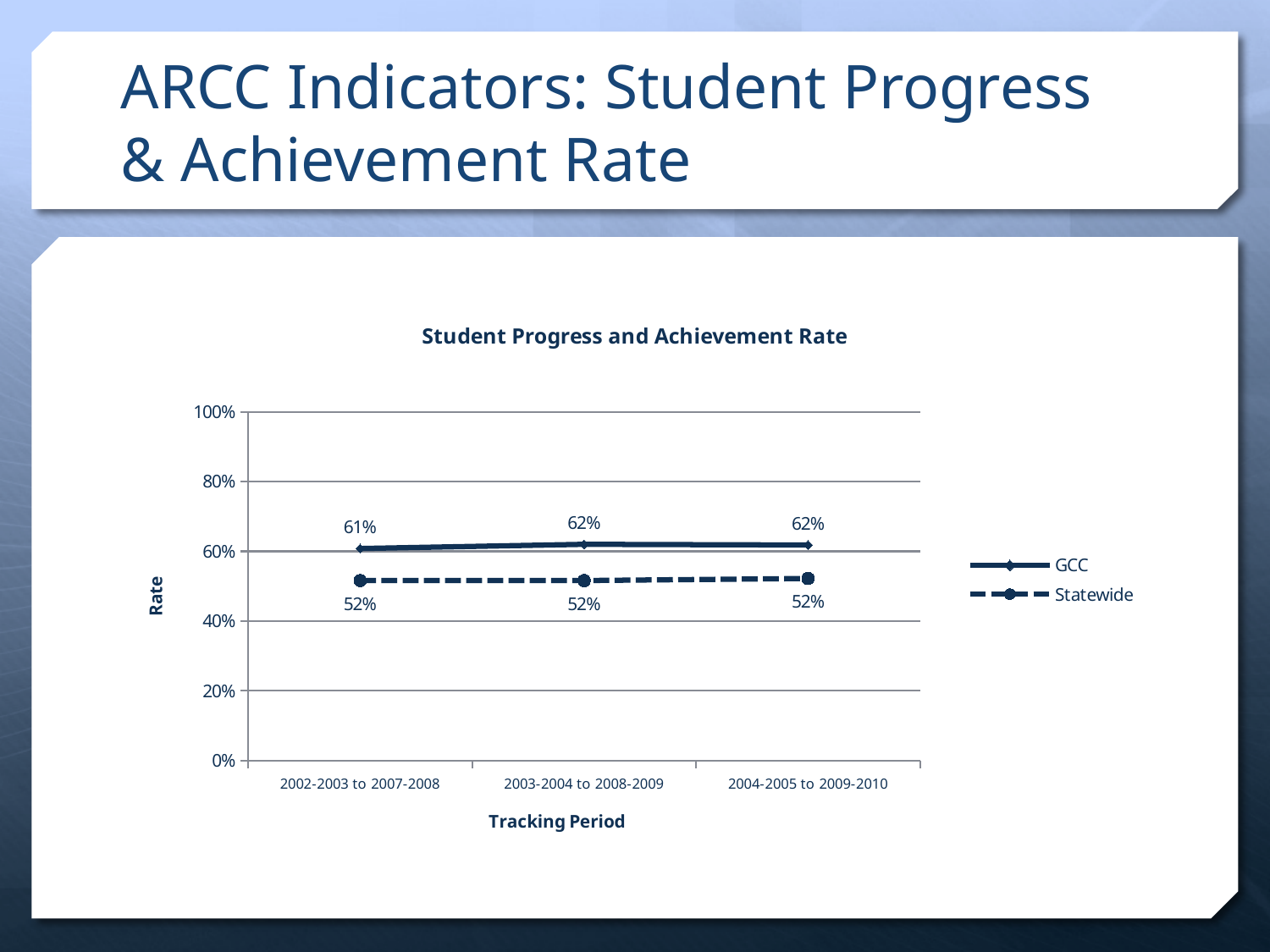
What is the difference between the GCC and Statewide values for the 2002-2003 to 2007-2008 tracking period? 9% What is the GCC value for the 2004-2005 to 2009-2010 tracking period? 62% What kind of chart is shown on the slide? line chart Which series has the higher value in the 2003-2004 to 2008-2009 tracking period, GCC or Statewide? GCC Does the Statewide series rise, fall, or stay flat across the tracking periods? stays flat What is the difference between the GCC and Statewide values for the 2004-2005 to 2009-2010 tracking period? 10% How many tracking periods are shown on the x axis? 3 How many series does the legend list? 2 What is the GCC value for the 2002-2003 to 2007-2008 tracking period? 61% Is the Statewide value for the 2002-2003 to 2007-2008 tracking period greater or less than 60%? less What is the title of the chart? Student Progress and Achievement Rate What is the Statewide value for the 2003-2004 to 2008-2009 tracking period? 52%